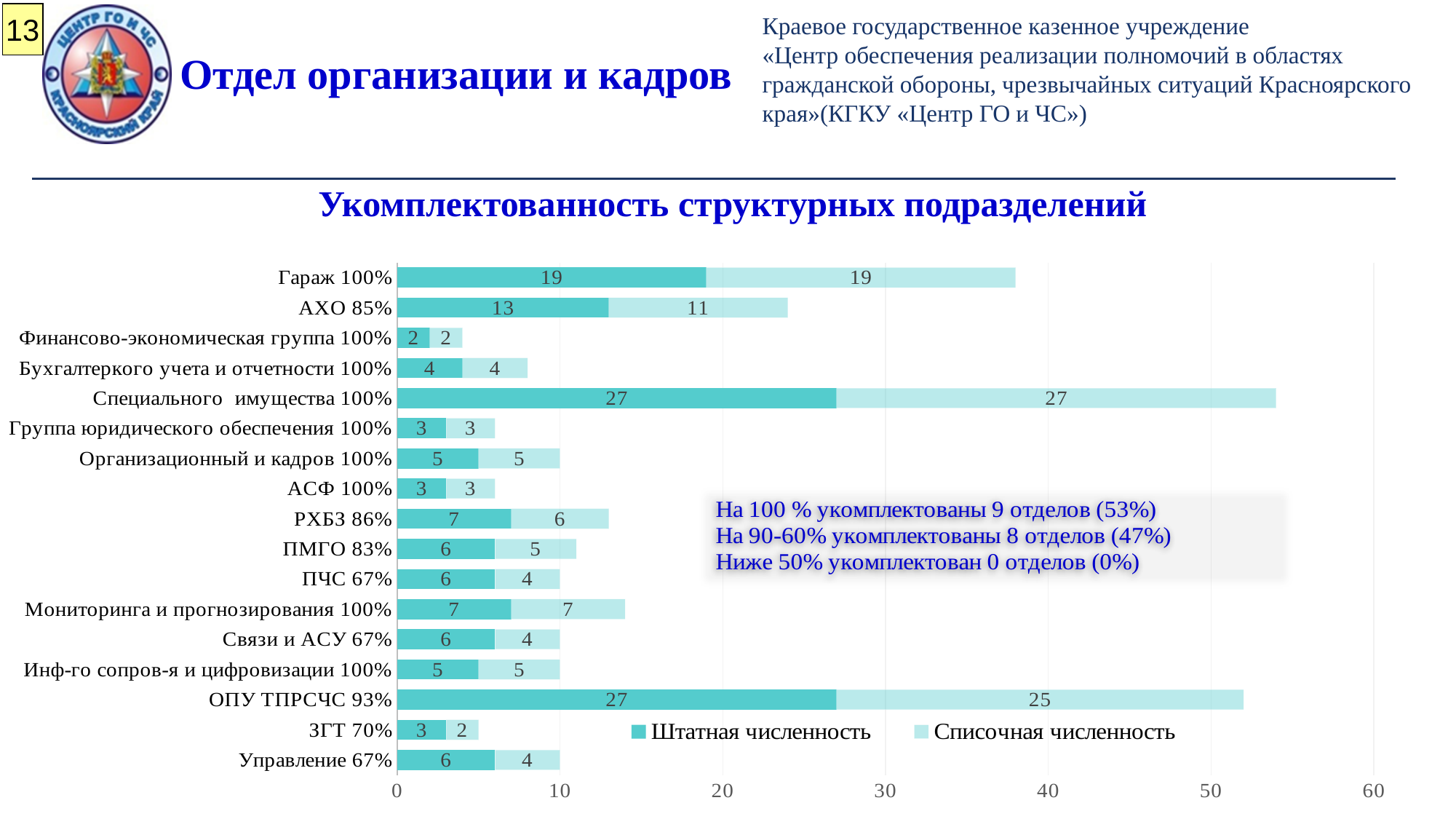
What is the total of the stacked bar for Специального имущества 100%? 54 What kind of chart is shown on the slide? Bar chart What is the Списочная численность value for ОПУ ТПРСЧС 93%? 25 What is the difference between Штатная численность and Списочная численность for ОПУ ТПРСЧС 93%? 2 How many series does the legend list? 2 What is the Списочная численность value for АХО 85%? 11 Which series is shown in the lighter colour in the legend? Списочная численность What is the Штатная численность value for Гараж 100%? 19 How many categories (departments) are plotted on the chart? 17 Which category has the highest Списочная численность value? Специального имущества 100% Which is larger: the Штатная численность for АХО 85% or for РХБЗ 86%? АХО 85% Which category has the lowest Штатная численность value? Финансово-экономическая группа 100%